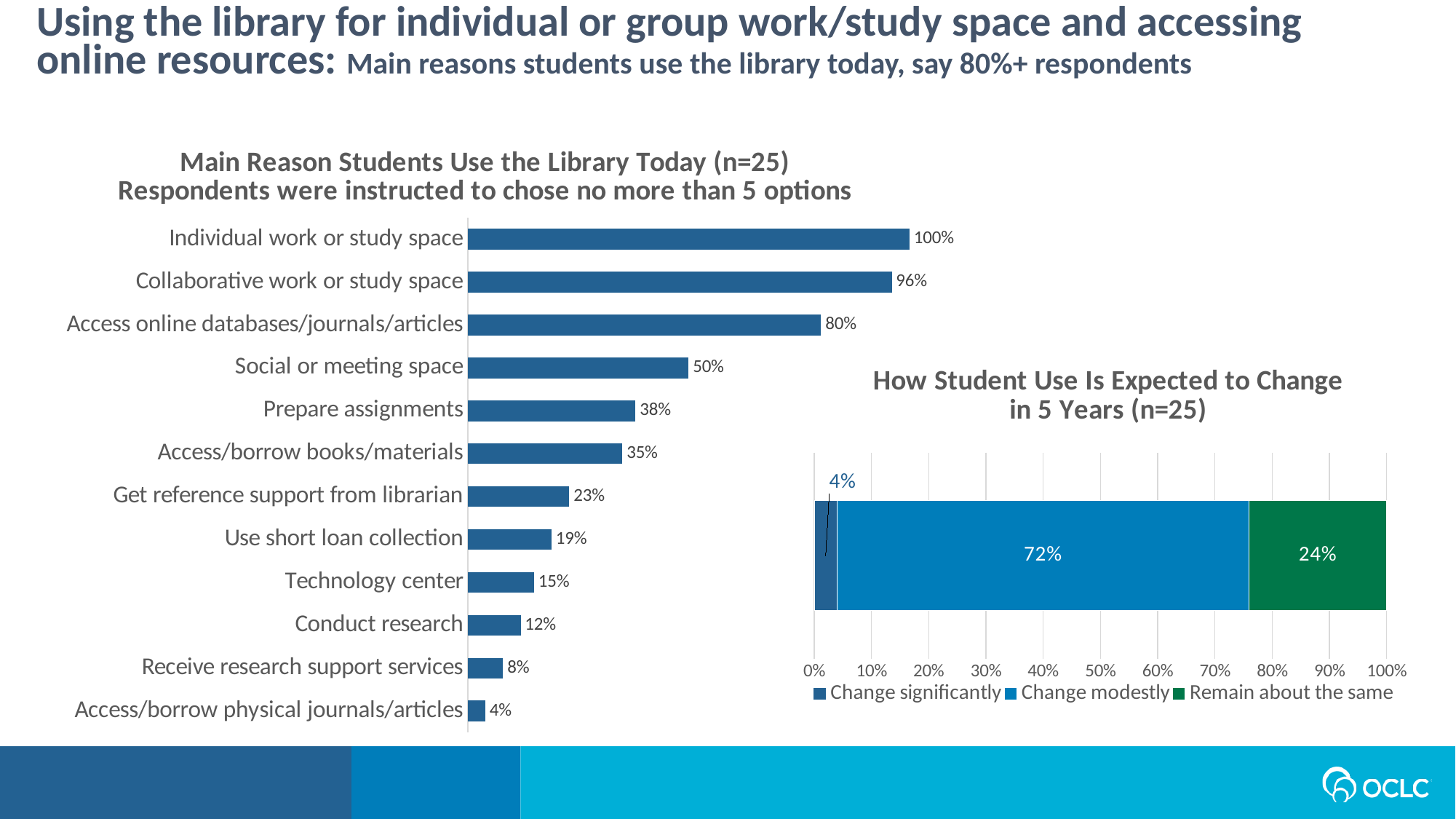
In the 'Main Reason Students Use the Library Today' chart, which category has the highest value? Individual work or study space How many categories are shown in the 'Main Reason Students Use the Library Today' chart? 12 In the 'Main Reason Students Use the Library Today' chart, what is the difference between 'Collaborative work or study space' and 'Access online databases/journals/articles'? 16% In the 'How Student Use Is Expected to Change in 5 Years' chart, what percentage is shown for 'Remain about the same'? 24% In the 'Main Reason Students Use the Library Today' chart, which is larger: 'Prepare assignments' or 'Access/borrow books/materials'? Prepare assignments What type of chart is the 'Main Reason Students Use the Library Today' chart? Bar chart In the 'How Student Use Is Expected to Change in 5 Years' chart, what percentage is shown for 'Change modestly'? 72% In the 'Main Reason Students Use the Library Today' chart, what percentage is shown for 'Social or meeting space'? 50% In the 'Main Reason Students Use the Library Today' chart, what percentage is shown for 'Get reference support from librarian'? 23% In the 'Main Reason Students Use the Library Today' chart, which category has the lowest value? Access/borrow physical journals/articles How many series does the legend list in the 'How Student Use Is Expected to Change in 5 Years' chart? 3 In the 'How Student Use Is Expected to Change in 5 Years' chart, what is the total of the stacked bar? 100%